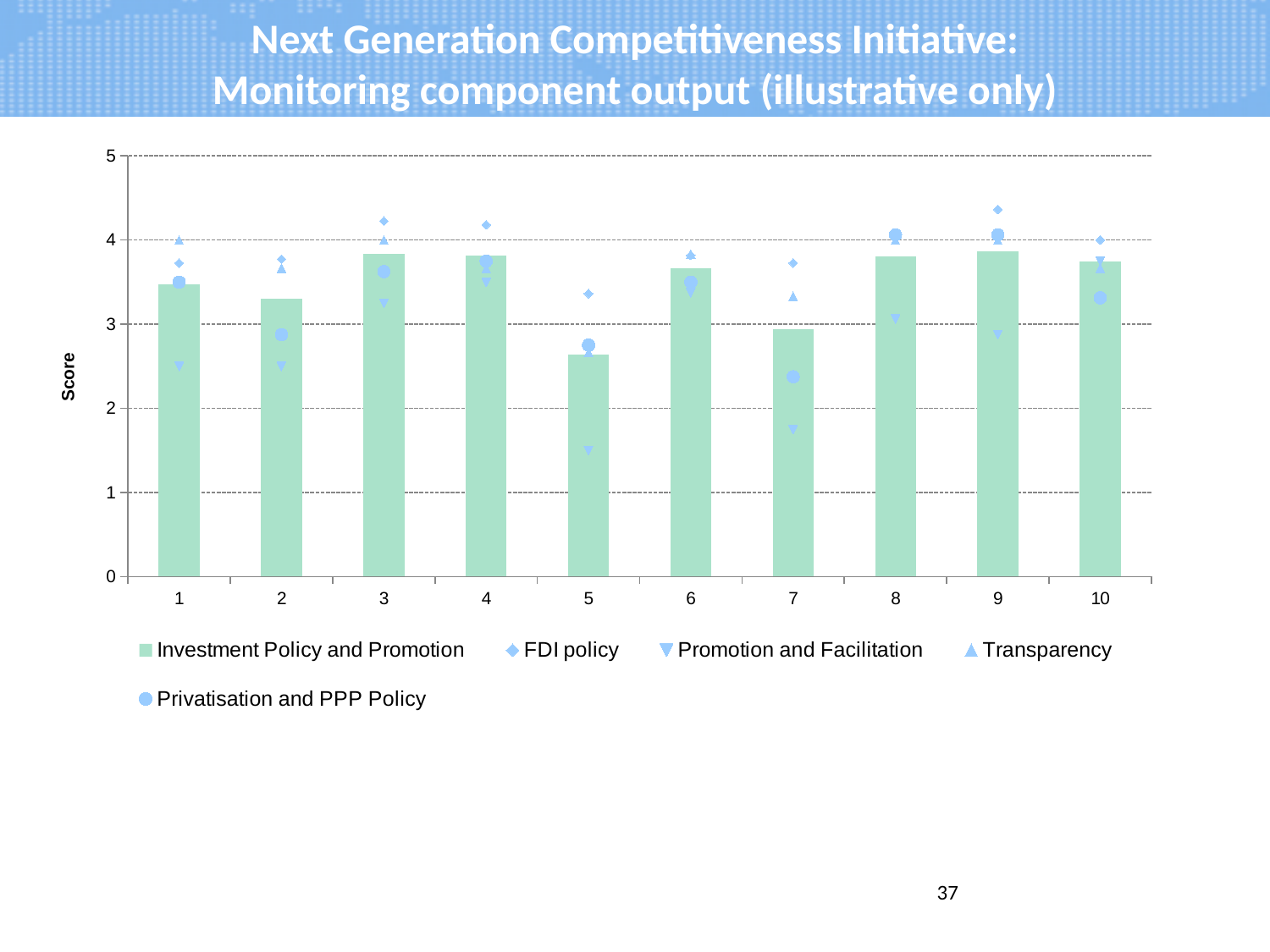
Is the Promotion and Facilitation marker for category 5 greater or less than 2? less What is the title of the vertical axis? Score Is the Investment Policy and Promotion bar for category 1 greater or less than 3? greater What kind of chart is shown on the slide? bar chart How many categories are shown along the x axis? 10 Which has the larger Investment Policy and Promotion bar, category 2 or category 3? category 3 Is the FDI policy marker for category 9 greater or less than 4? greater How many series does the legend list? 5 Which category has the lowest Investment Policy and Promotion bar? 5 Which has the larger Investment Policy and Promotion bar, category 6 or category 7? category 6